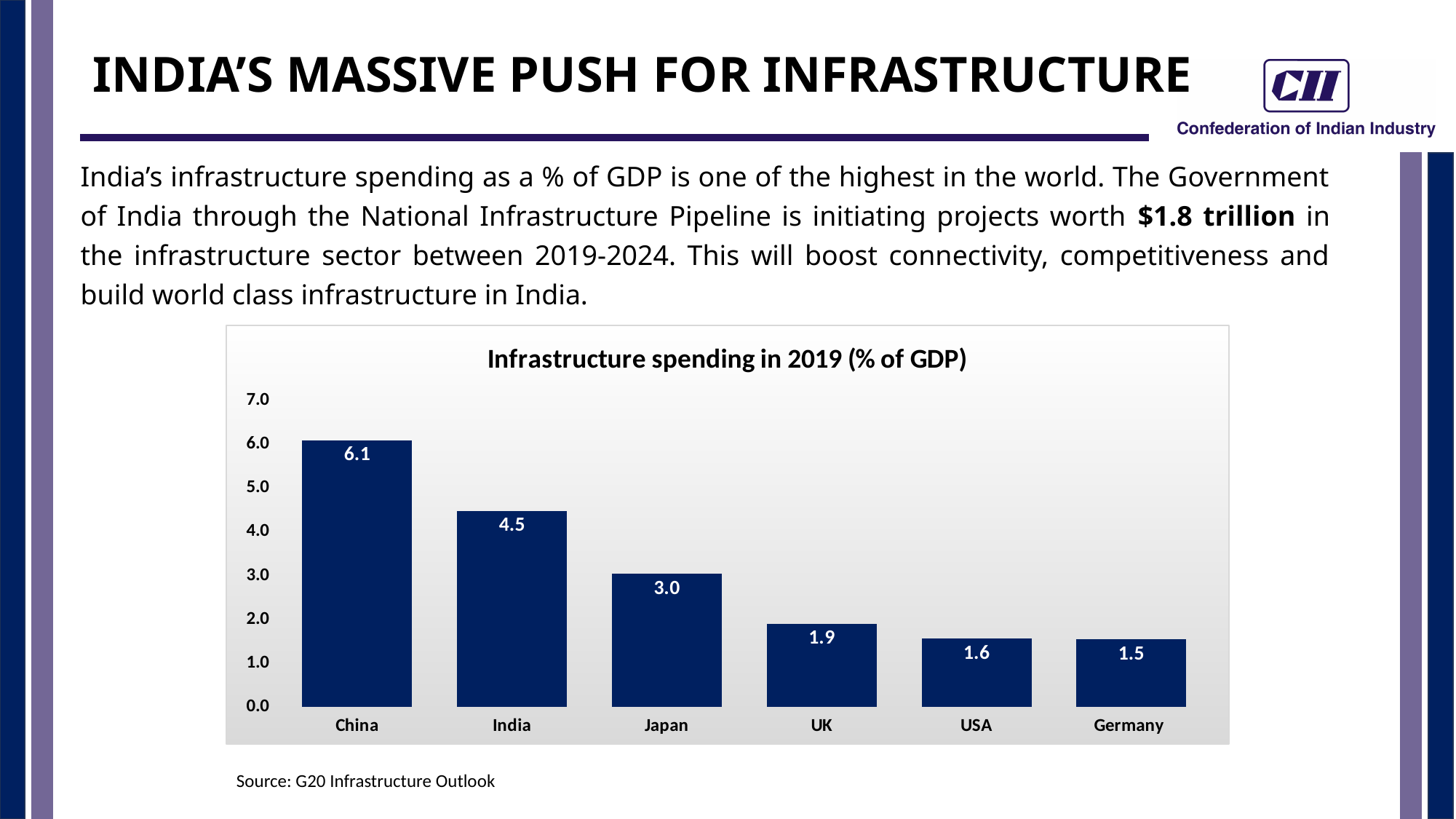
Which country has the highest infrastructure spending as % of GDP? China What is the infrastructure spending value for China? 6.1 What kind of chart is shown on the slide? bar chart Which country has the lowest infrastructure spending as % of GDP? Germany What is the difference between Japan's and UK's values? 1.1 Which is larger, the value for UK or the value for USA? UK What is the difference between China's and India's values? 1.6 What is the title of the chart? Infrastructure spending in 2019 (% of GDP) What is the infrastructure spending value for India? 4.5 How many countries are shown in the chart? 6 Is the value for Japan greater or less than 2.0? greater What is the infrastructure spending value for Germany? 1.5